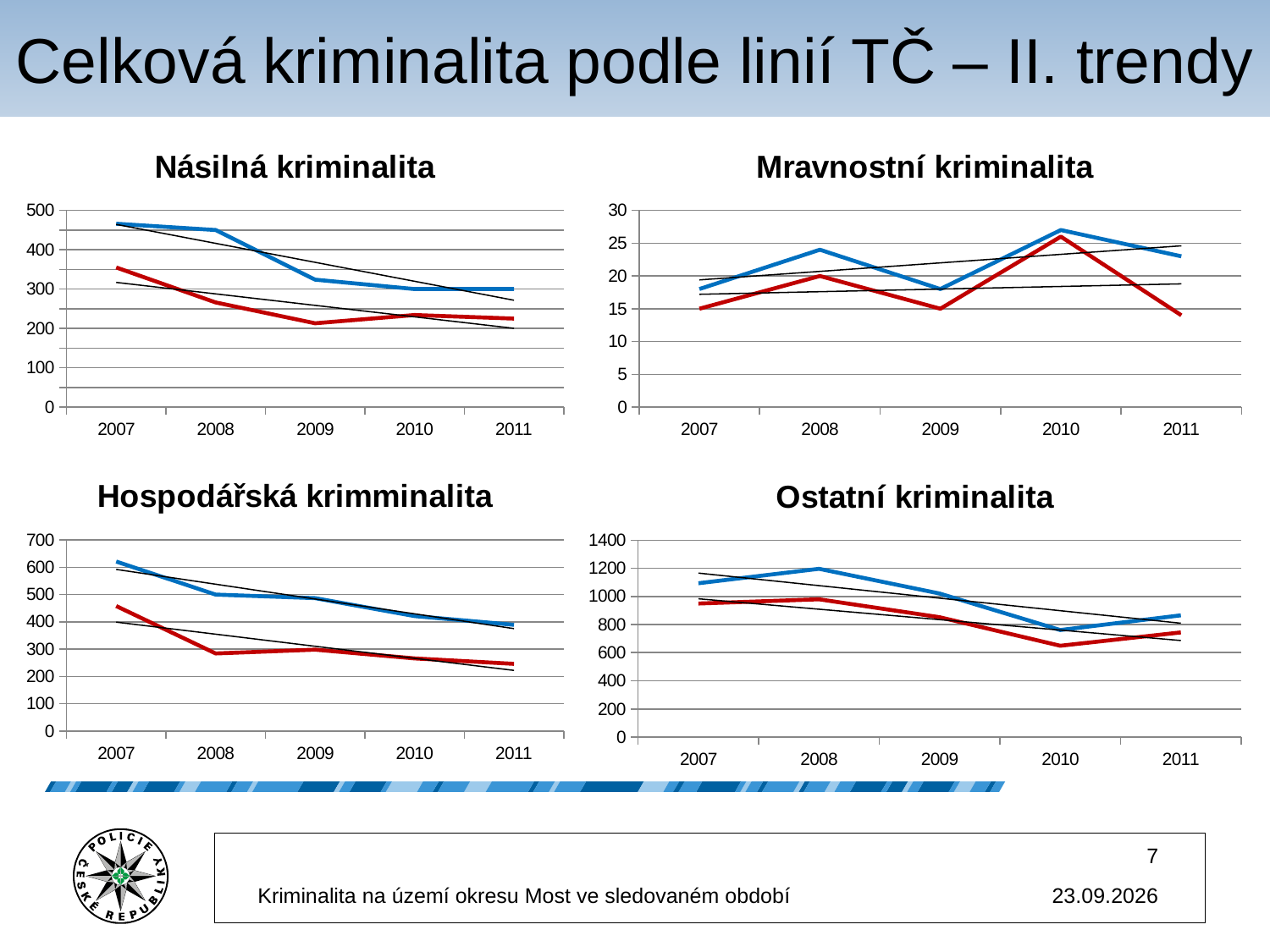
In the 'Násilná kriminalita' chart, which line has the higher value in 2007, the blue or the red? blue In the 'Ostatní kriminalita' chart, in which year does the blue line reach its highest value? 2008 In the 'Hospodářská krimminalita' chart, is the red line's value for 2011 greater or less than 300? less In the 'Mravnostní kriminalita' chart, is the blue line's value for 2010 greater or less than 25? greater What kind of chart is the 'Násilná kriminalita' chart? line chart How many years are shown on the x axis of the 'Mravnostní kriminalita' chart? 5 In the 'Mravnostní kriminalita' chart, in which year does the blue line reach its highest value? 2010 In the 'Hospodářská krimminalita' chart, is the blue line's value for 2007 greater or less than 600? greater How many charts are shown on the slide? 4 In the 'Násilná kriminalita' chart, does the blue line generally rise or fall from 2007 to 2011? fall In the 'Ostatní kriminalita' chart, in which year does the red line reach its lowest value? 2010